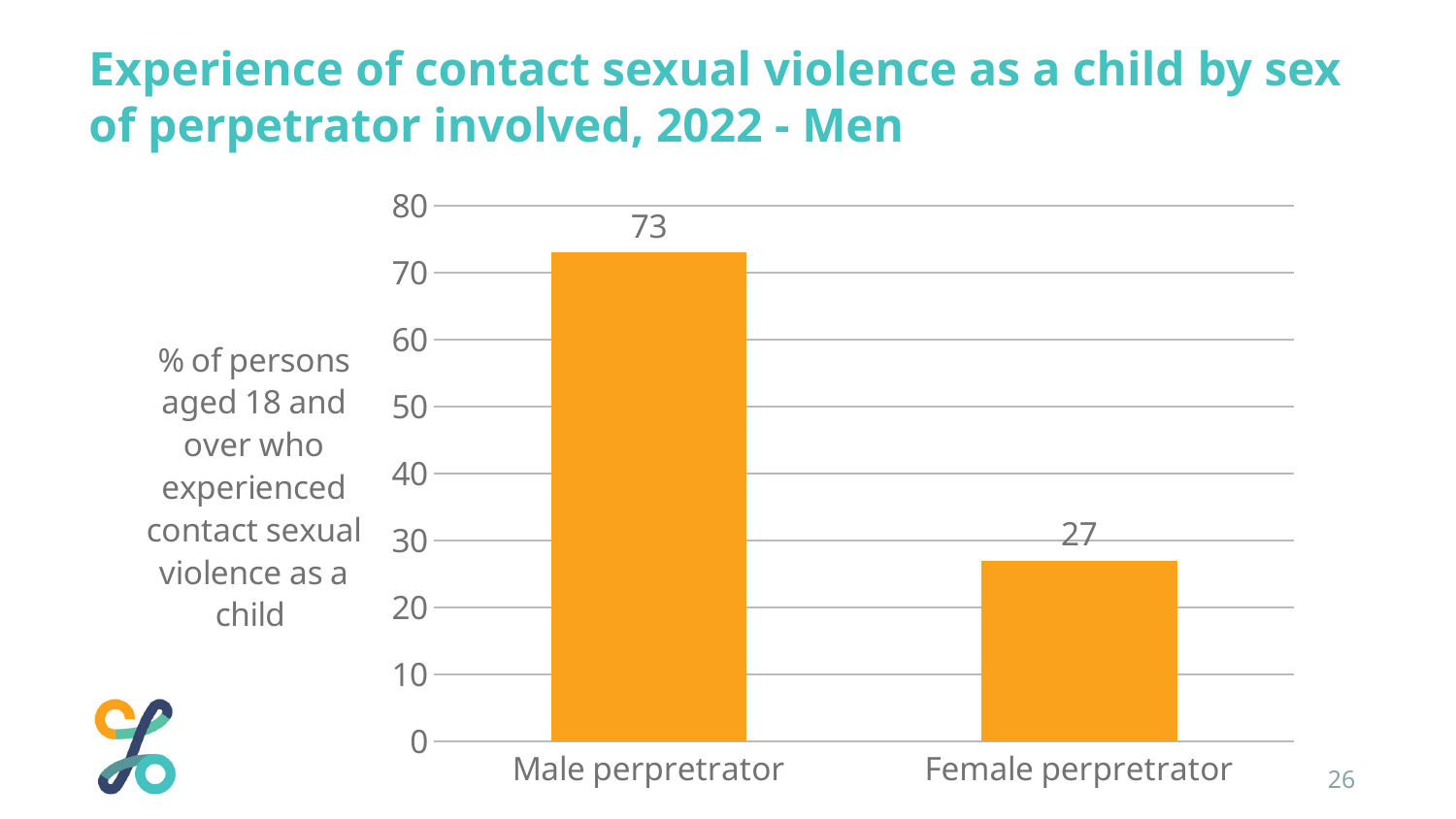
Which is larger, the value for Male perpretrator or Female perpretrator? Male perpretrator What is the value for Male perpretrator? 73 Is the value for Male perpretrator greater or less than 70? greater What is the value for Female perpretrator? 27 What is the difference between the values for Male perpretrator and Female perpretrator? 46 What is the total of the two values shown on the chart? 100 Which category has the lowest value? Female perpretrator What is the title of the chart? Experience of contact sexual violence as a child by sex of perpetrator involved, 2022 - Men What kind of chart is shown on the slide? Bar chart How many categories are shown on the chart? 2 Is the value for Female perpretrator greater or less than 30? less Which category has the highest value? Male perpretrator